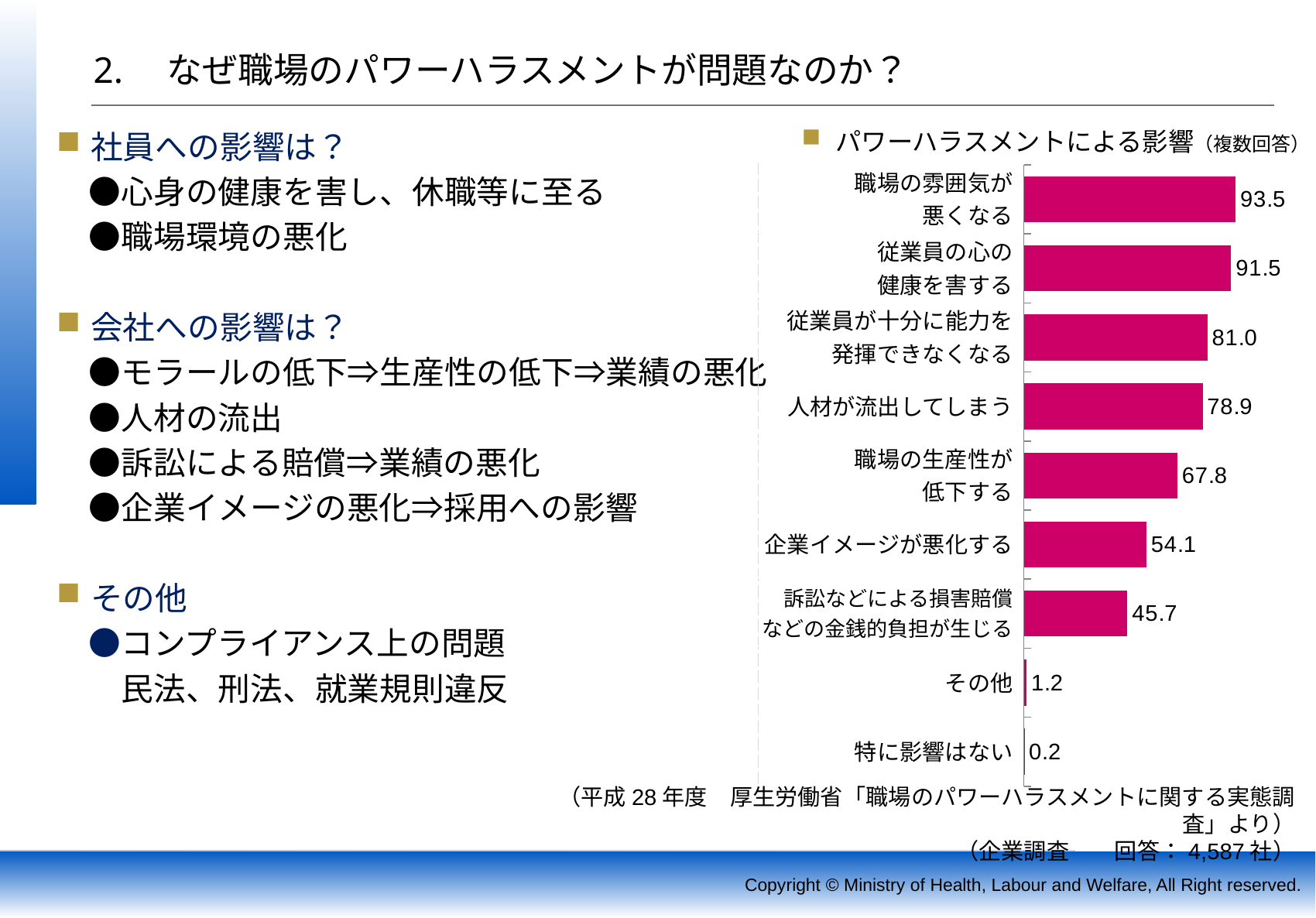
What is the value for 特に影響はない? 0.2 Which category has the lowest value? 特に影響はない What is the title of the chart? パワーハラスメントによる影響（複数回答） What is the value for 訴訟などによる損害賠償などの金銭的負担が生じる? 45.7 What is the value for 人材が流出してしまう? 78.9 What kind of chart is shown on the slide? bar chart Which is larger, 従業員が十分に能力を発揮できなくなる or 人材が流出してしまう? 従業員が十分に能力を発揮できなくなる What is the value for 職場の雰囲気が悪くなる? 93.5 Which category has the highest value? 職場の雰囲気が悪くなる What is the difference between 職場の雰囲気が悪くなる and 従業員の心の健康を害する? 2.0 How many categories are shown in the chart? 9 What is the difference between 職場の生産性が低下する and 企業イメージが悪化する? 13.7